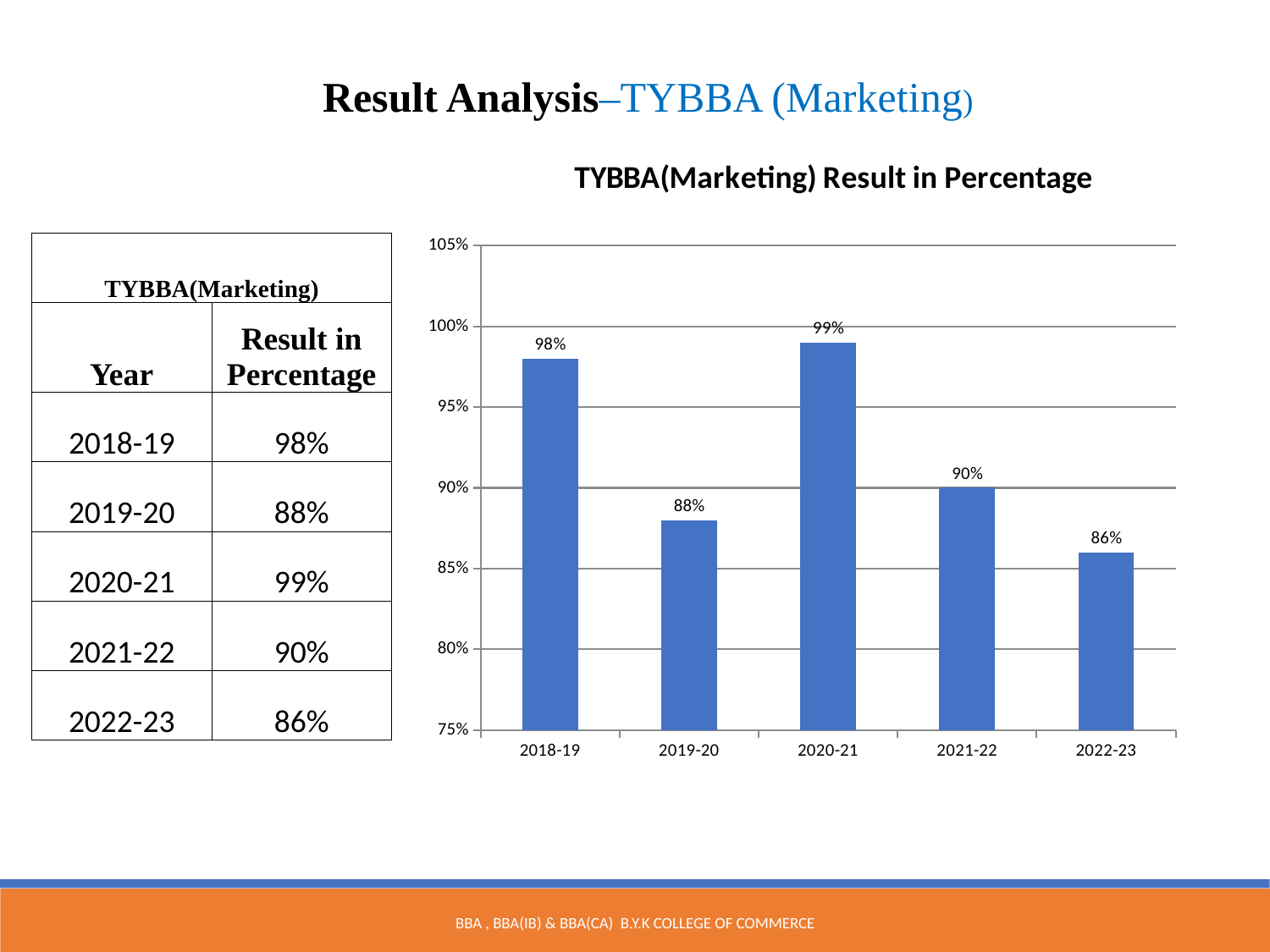
What is the result percentage for 2021-22? 90% What is the difference between the result percentages for 2020-21 and 2022-23? 13% What is the title of the chart? TYBBA(Marketing) Result in Percentage What kind of chart is shown on the slide? Bar chart Is the value for 2019-20 greater or less than 90%? less Which year has the lowest result percentage? 2022-23 Which year has a higher result percentage, 2019-20 or 2021-22? 2021-22 How many years are shown on the chart? 5 What is the result percentage for 2018-19? 98% What is the difference between the result percentages for 2018-19 and 2019-20? 10% What is the result percentage for 2022-23? 86% Which year has the highest result percentage? 2020-21